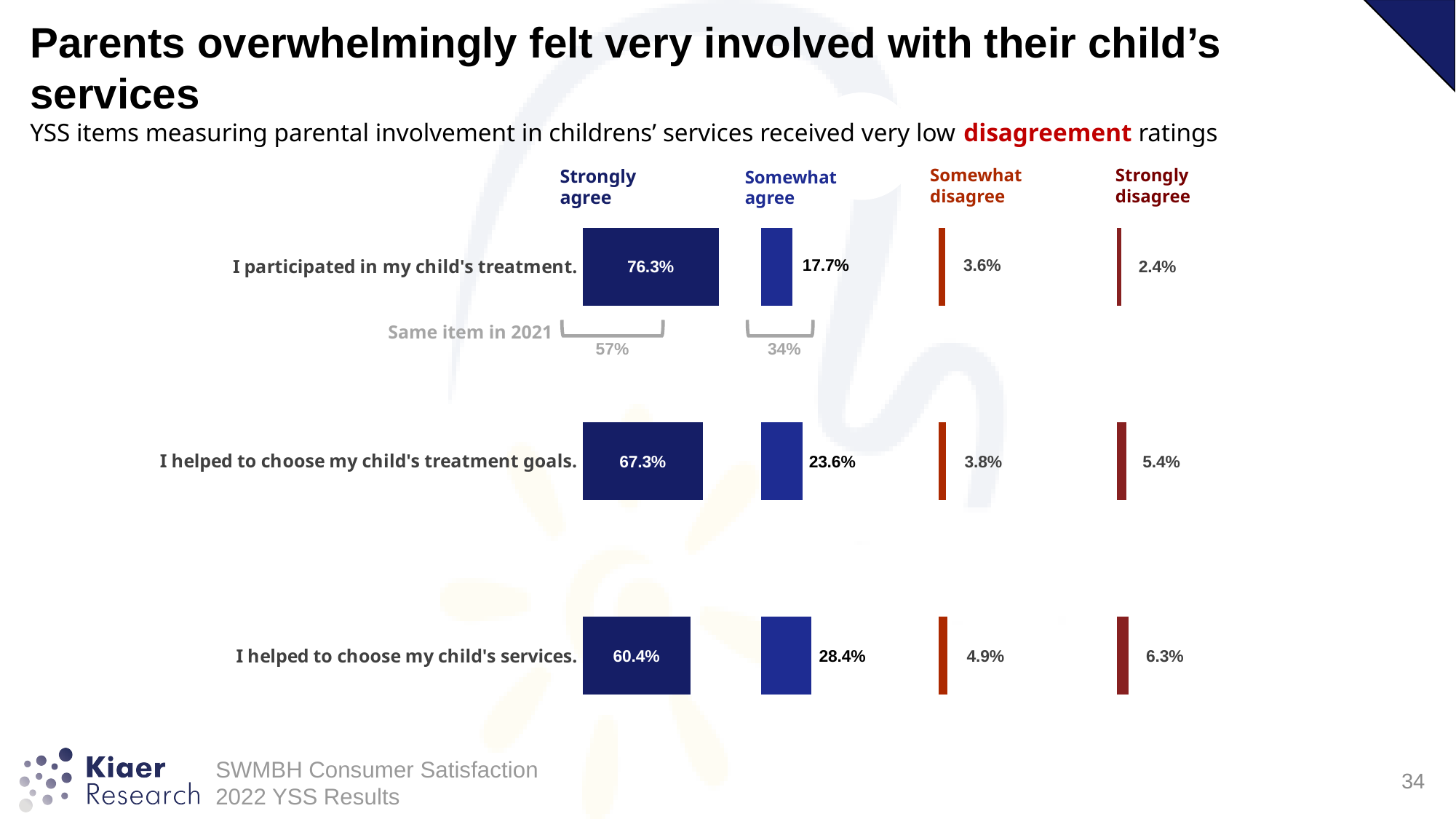
Which is larger: the "Somewhat disagree" percentage for "I helped to choose my child's services." or for "I helped to choose my child's treatment goals."? I helped to choose my child's services. How many survey items are shown in the chart? 3 How many response categories are shown across the top of the chart? 4 Which item has the highest "Strongly agree" percentage? I participated in my child's treatment. Which item has the lowest "Strongly disagree" percentage? I participated in my child's treatment. What is the difference between the "Strongly agree" percentages for "I participated in my child's treatment." and "I helped to choose my child's services."? 15.9% What percentage of parents somewhat agreed with "I helped to choose my child's services."? 28.4% What was the "Strongly agree" percentage for "I participated in my child's treatment." for the same item in 2021? 57% What percentage of parents strongly agreed with "I participated in my child's treatment."? 76.3% What type of chart is shown on the slide? Bar chart Which word in the subtitle is highlighted in red? disagreement What percentage of parents strongly disagreed with "I helped to choose my child's treatment goals."? 5.4%